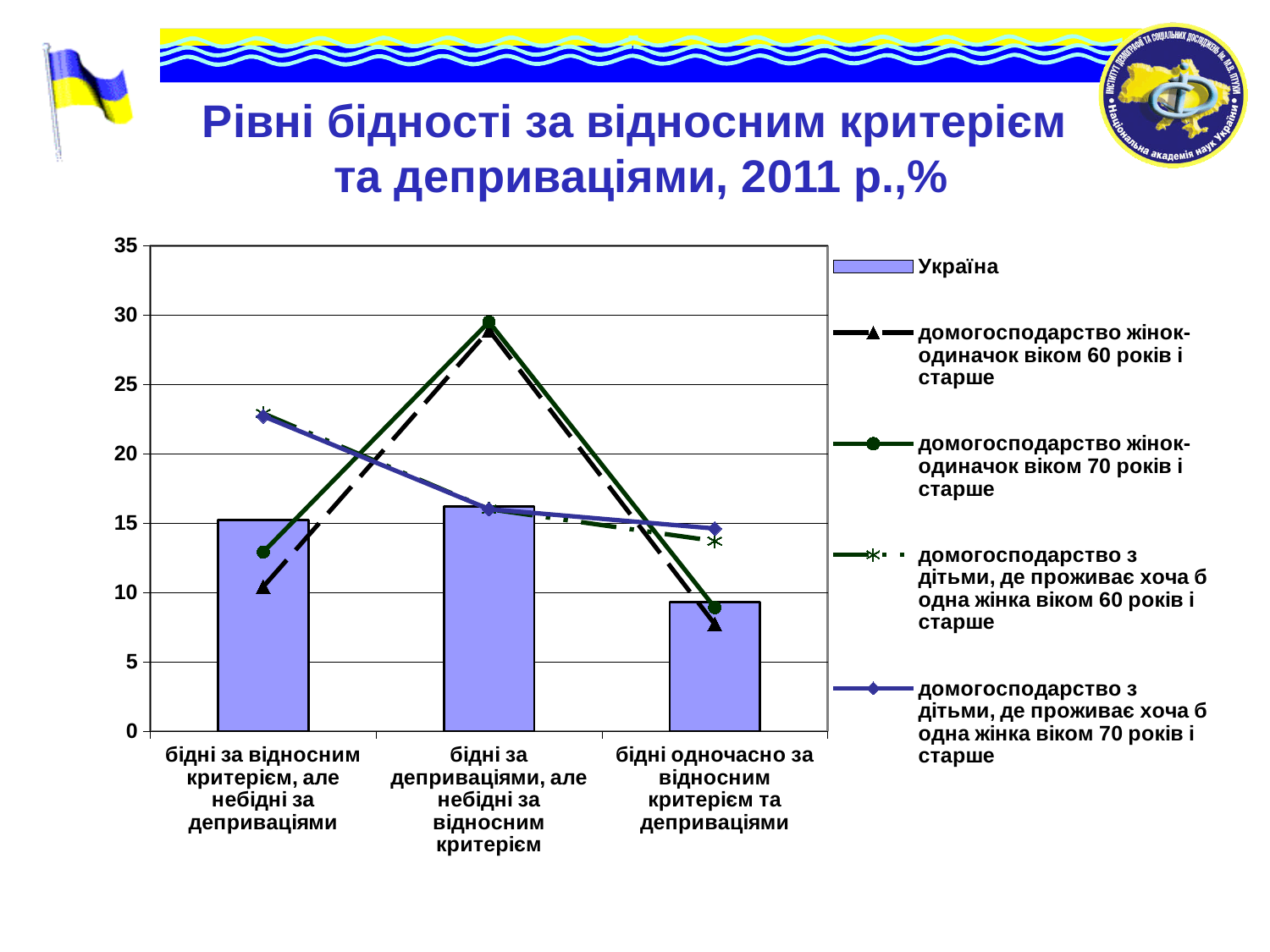
What is the title of the chart on the slide? Рівні бідності за відносним критерієм та депривaціями, 2011 р.,% Do the values for "домогосподарство з дітьми, де проживає хоча б одна жінка віком 70 років і старше" rise or fall from left to right across the categories? fall Which series is shown as bars in the chart? Україна What kind of chart is shown on the slide? A combined bar and line chart How many series does the chart legend list? 5 In the category "бідні за відносним критерієм, але небідні за депривaціями", which is larger: the value for "домогосподарство з дітьми, де проживає хоча б одна жінка віком 60 років і старше" or for "домогосподарство жінок-одиначок віком 60 років і старше"? домогосподарство з дітьми, де проживає хоча б одна жінка віком 60 років і старше How many categories are shown along the x axis of the chart? 3 For the series Україна, which category has the lowest value? бідні одночасно за відносним критерієм та депривaціями Is the value for Україна in the category "бідні одночасно за відносним критерієм та депривaціями" greater or less than 10? less For the series "домогосподарство жінок-одиначок віком 70 років і старше", which category has the highest value? бідні за депривaціями, але небідні за відносним критерієм Is the value for "домогосподарство жінок-одиначок віком 60 років і старше" in the category "бідні за депривaціями, але небідні за відносним критерієм" greater or less than 25? greater Is the value for Україна in the category "бідні за депривaціями, але небідні за відносним критерієм" greater or less than 15? greater